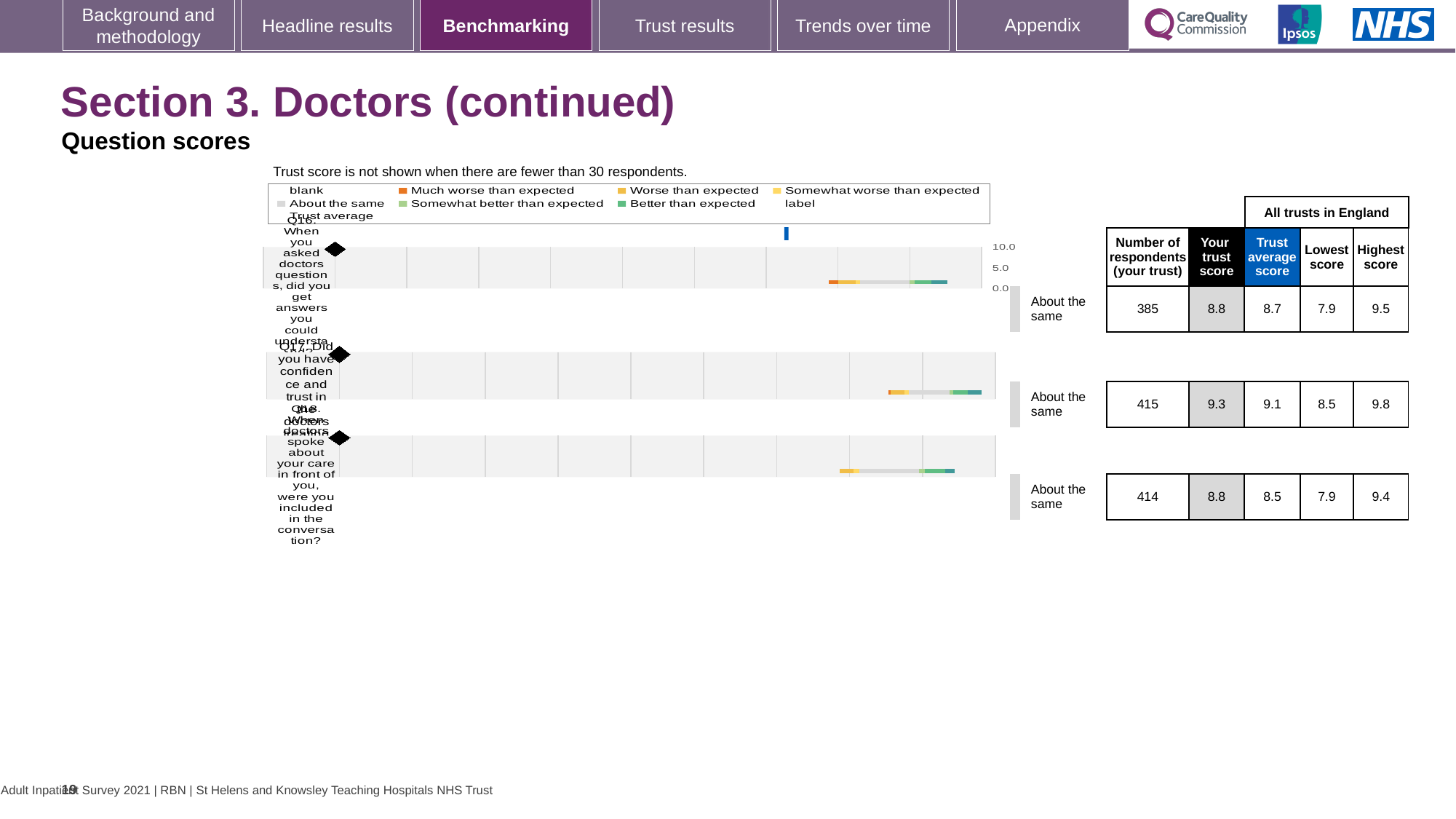
How many questions (categories) are plotted in the benchmarking chart? 3 What is the highest score across all trusts in England for Q18? 9.4 Which question has the highest 'Your trust score'? Q17 For Q16, which is larger: the trust score or the trust average score? Your trust score (8.8) What is the 'Your trust score' value for Q17 (confidence and trust in the doctors)? 9.3 What kind of chart is used to show the question scores? bar chart How many respondents from the trust answered Q16? 385 What is the maximum tick value shown on the chart's score axis? 10.0 What benchmark category is shown for Q16? About the same What is the trust average score for Q18? 8.5 What is the difference between the trust score and the trust average score for Q17? 0.2 What is the lowest score across all trusts in England for Q17? 8.5